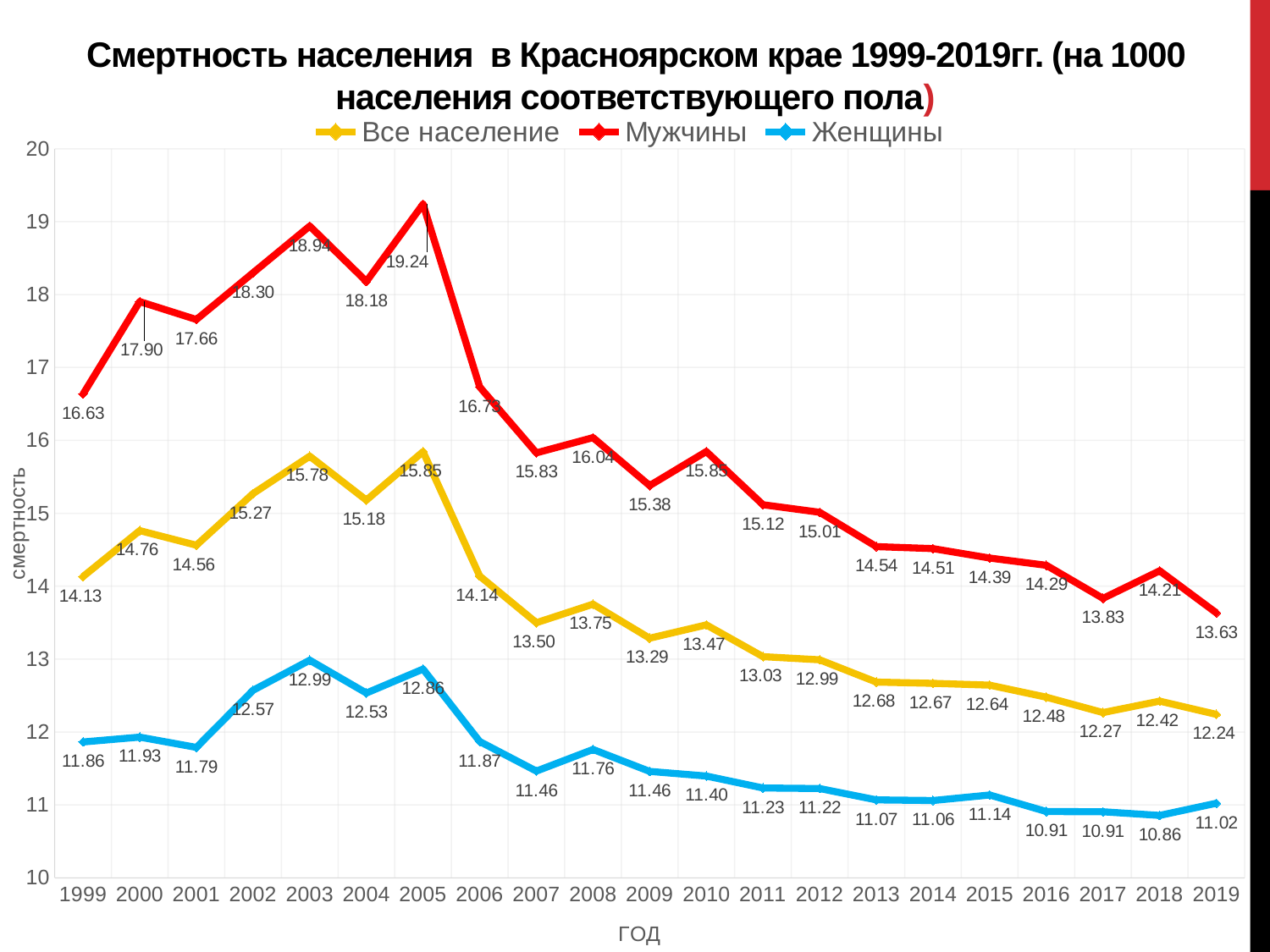
Does the Все население series rise or fall from 2005 to 2019? fall Is the value for Мужчины in 1999 greater or less than 16? greater Which is larger: the Все население value in 2000 or in 2001? 2000 What is the value for Мужчины in 2005? 19.24 What is the value for Все население in 2003? 15.78 How many series does the legend list? 3 How many years are plotted along the x axis? 21 What is the value for Женщины in 2019? 11.02 In which year does the Женщины series reach its lowest value? 2018 What kind of chart is shown on the slide? line chart What is the difference between the Мужчины values in 2005 and 2019? 5.61 In which year does the Мужчины series reach its highest value? 2005